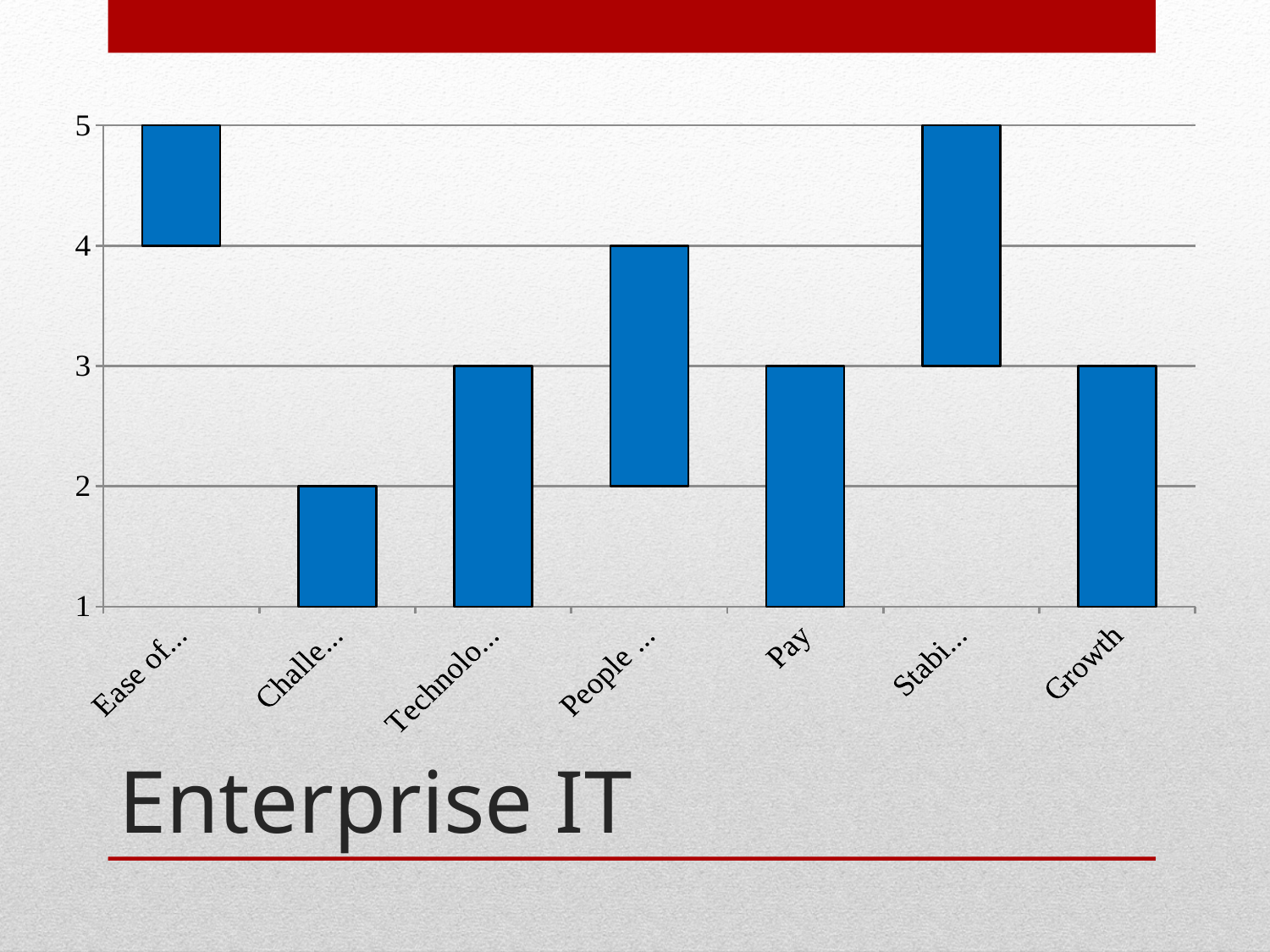
What colour are the bars in the chart? blue What is the top value of the bar for Pay? 3 At what value does the bottom of the leftmost bar start? 4 What is the top value of the bar for Growth? 3 At what value does the bottom of the Growth bar start? 1 What is the top value of the leftmost bar in the chart? 5 What is the title text shown below the chart? Enterprise IT How many categories are shown along the x axis of the chart? 7 Is the top of the bar for Growth greater or less than 2? greater Is the top of the bar for Pay greater or less than 4? less At what value does the bottom of the Pay bar start? 1 What kind of chart is shown on the slide? bar chart